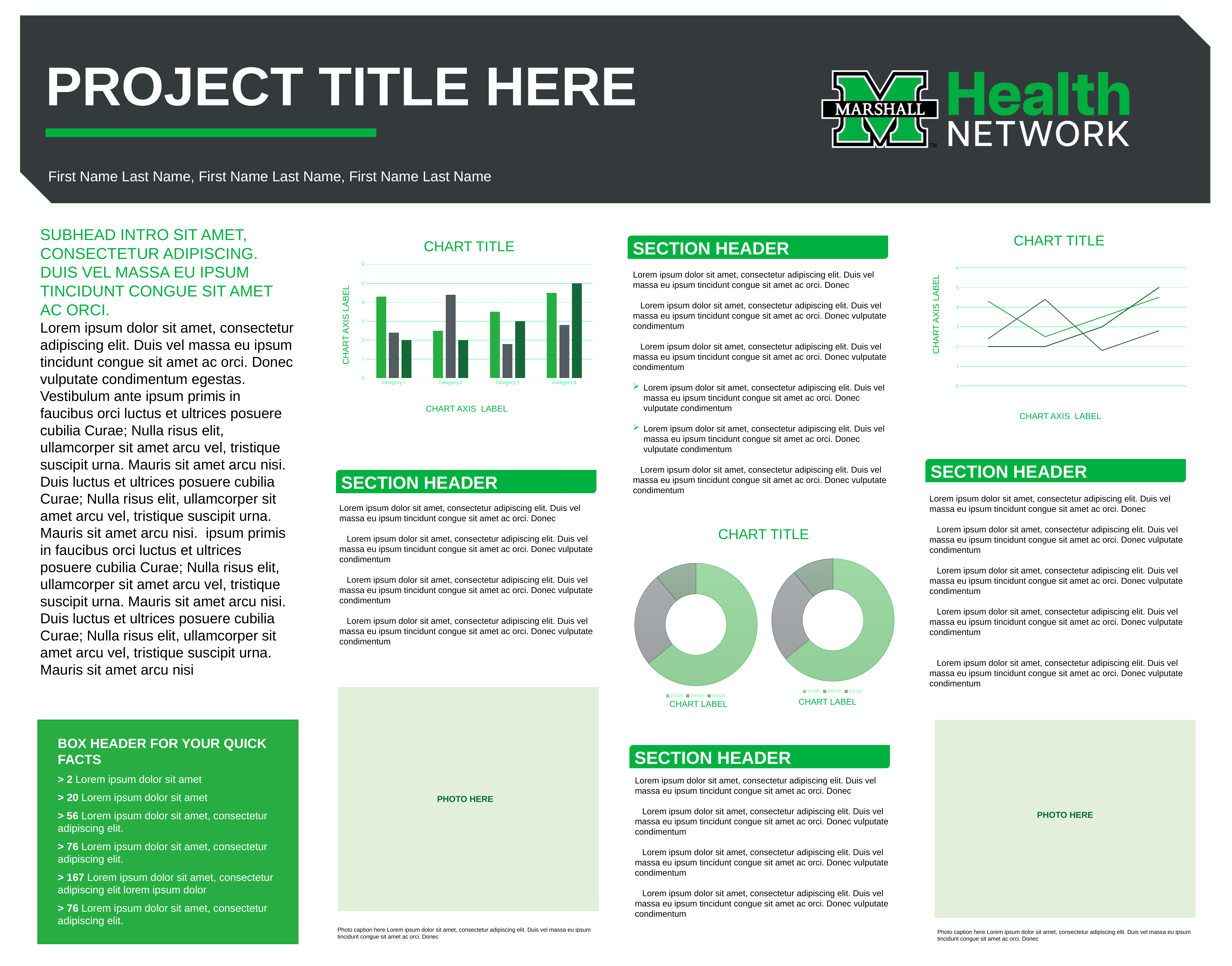
In the bar chart at the top of the second column, is the value of the light green bar for Category 3 greater or less than 3? greater In the bar chart at the top of the second column, is the value of the dark green bar for Category 1 greater or less than 3? less What kind of charts are the two charts in the middle of the third column? doughnut charts In the bar chart at the top of the second column, how many categories are shown on the x axis? 4 In the line chart at the top of the right-hand column, how many lines are plotted? 3 What kind of chart is the chart at the top of the right-hand column? line chart In the bar chart at the top of the second column, how many bars are plotted for each category? 3 In the bar chart at the top of the second column, which category contains the tallest bar? Category 4 How many entries does the legend list for each doughnut chart in the middle of the third column? 3 In the bar chart at the top of the second column, is the value of the dark green bar for Category 4 greater or less than 4? greater What is the x-axis label of the bar chart at the top of the second column? CHART AXIS LABEL What kind of chart is the chart at the top of the second column (with Category 1 to Category 4)? bar chart